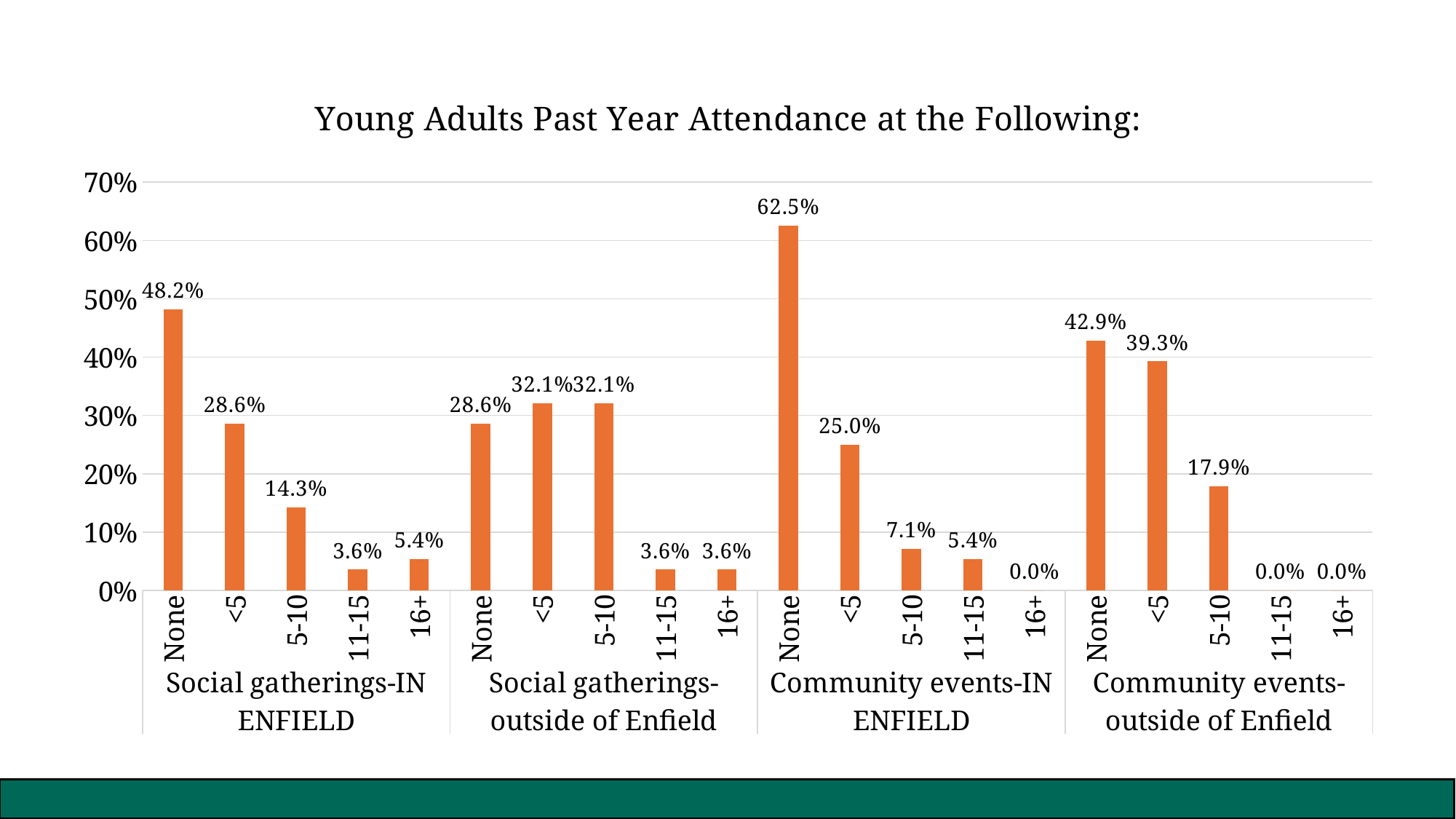
Which group and category has the highest value on the chart? None, Community events-IN ENFIELD What is the difference between "None" and "<5" under Social gatherings-IN ENFIELD? 19.6% What kind of chart is shown on the slide? bar chart Within the Social gatherings-IN ENFIELD group, which category has the lowest value? 11-15 How many bars are plotted on the chart in total? 20 Is the value for "<5" under Community events-IN ENFIELD greater or less than 30%? less Within the Community events-outside of Enfield group, do the values rise or fall from "None" to "16+"? fall What is the value for "5-10" under Social gatherings-IN ENFIELD? 14.3% What is the value for "None" under Community events-IN ENFIELD? 62.5% What is the title of the chart? Young Adults Past Year Attendance at the Following: What is the value for "<5" under Community events-outside of Enfield? 39.3% Which is larger: "None" under Social gatherings-IN ENFIELD or "None" under Community events-outside of Enfield? None under Social gatherings-IN ENFIELD